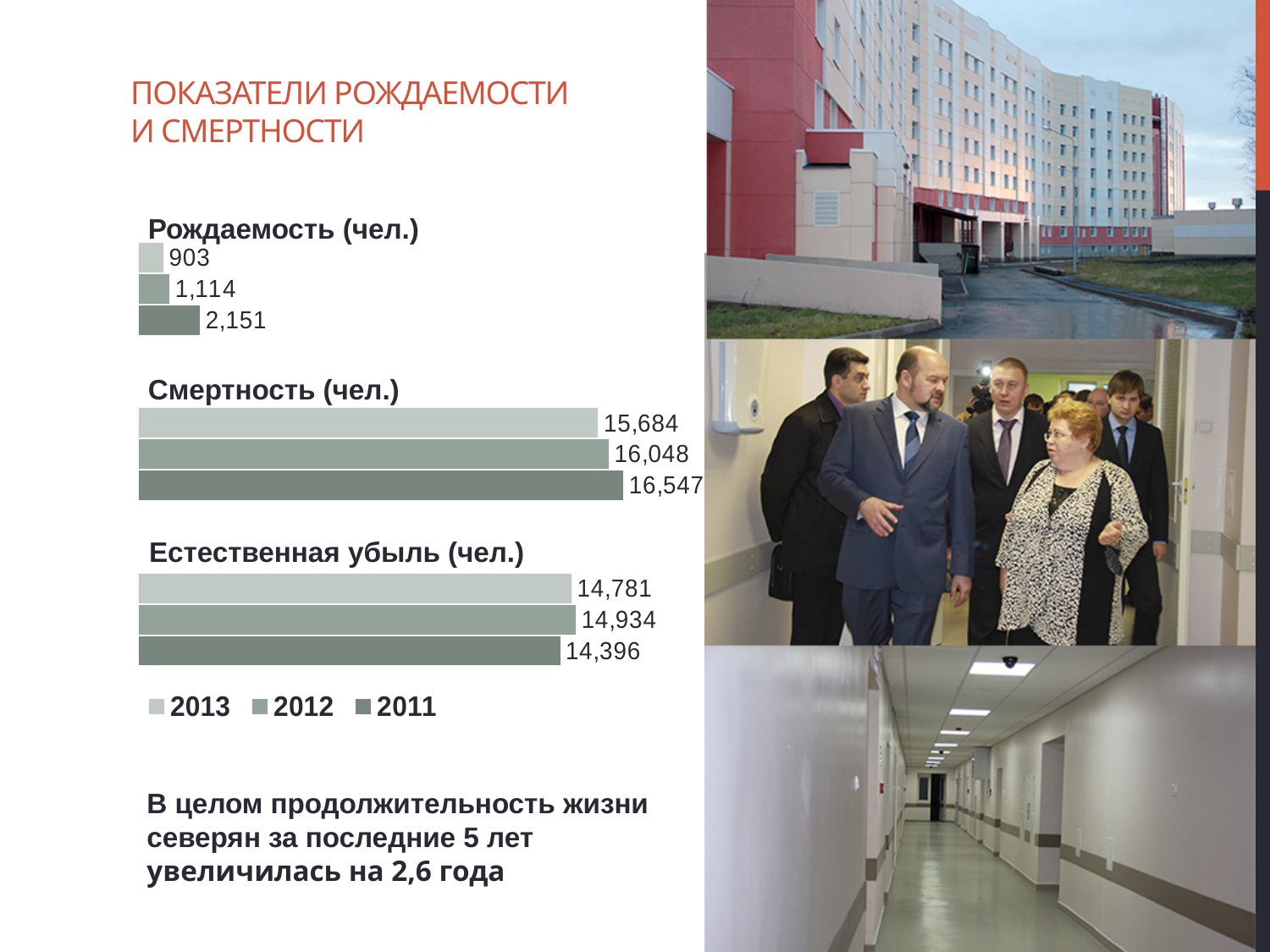
How many series does the chart legend list? 3 What is the value for Рождаемость (чел.) in 2013? 903 Which years are listed in the chart legend? 2013, 2012, 2011 What kind of chart is shown on the slide? bar chart What is the value for Смертность (чел.) in 2012? 16,048 What is the difference between Смертность (чел.) in 2011 and in 2013? 863 In which year was Рождаемость (чел.) lowest? 2013 How many categories does the chart show? 3 In which year was Смертность (чел.) highest? 2011 What is the value for Рождаемость (чел.) in 2011? 2,151 Which is larger: Естественная убыль (чел.) in 2012 or in 2011? 2012 What is the value for Естественная убыль (чел.) in 2011? 14,396